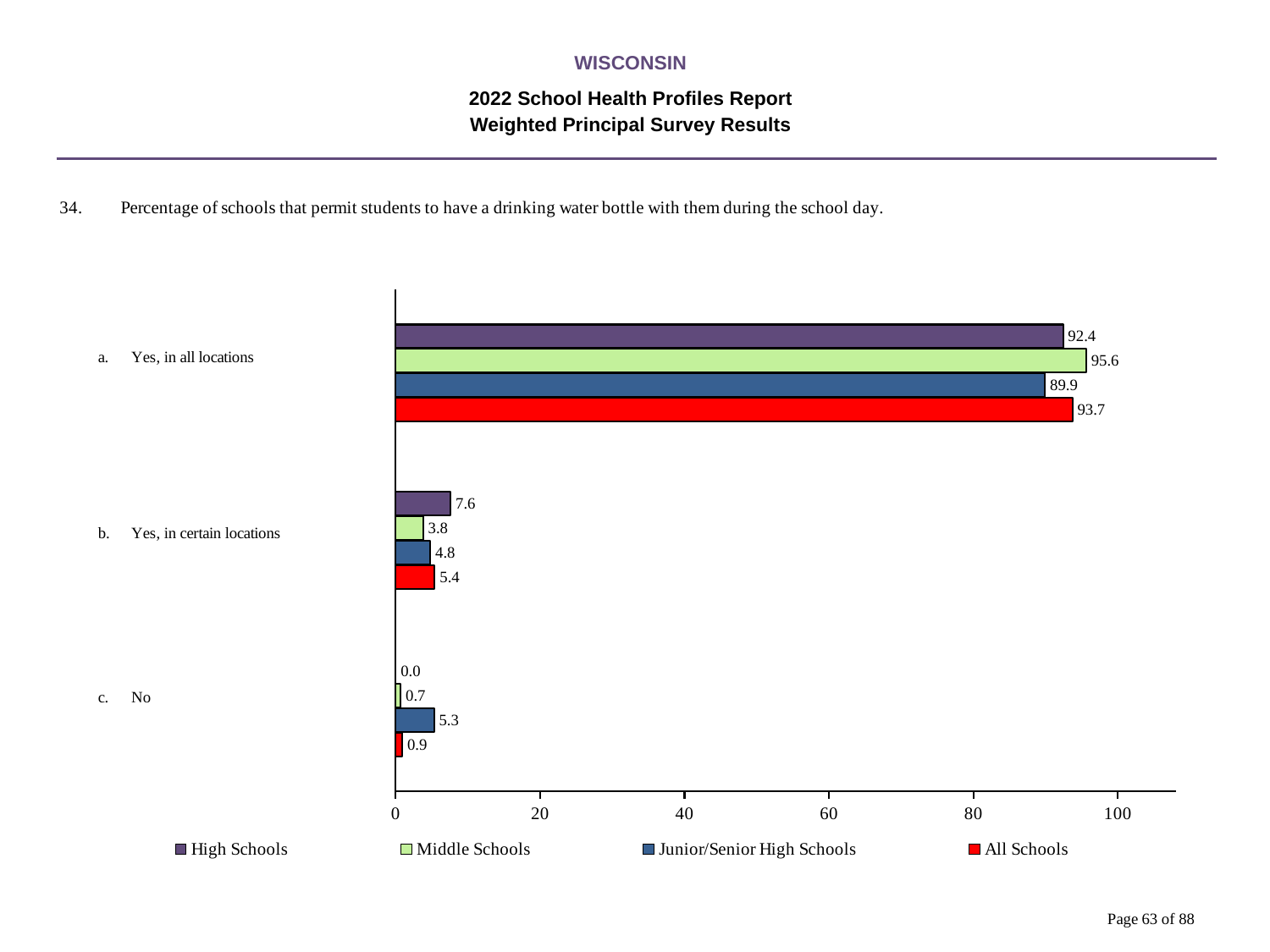
How many categories are shown on the chart? 3 Which series has the highest value in the 'Yes, in all locations' category? Middle Schools How many series does the legend list? 4 What is the difference between the High Schools and Middle Schools values in the 'Yes, in certain locations' category? 3.8 What is the value for Middle Schools in the 'Yes, in all locations' category? 95.6 What colour are the All Schools bars? red What is the value for All Schools in the 'Yes, in certain locations' category? 5.4 What is the value for Junior/Senior High Schools in the 'No' category? 5.3 Is the value for All Schools in the 'Yes, in all locations' category greater or less than 80? greater What kind of chart is shown on the slide? bar chart In the 'Yes, in all locations' category, which is larger: the value for High Schools or for Junior/Senior High Schools? High Schools Which series has the lowest value in the 'No' category? High Schools